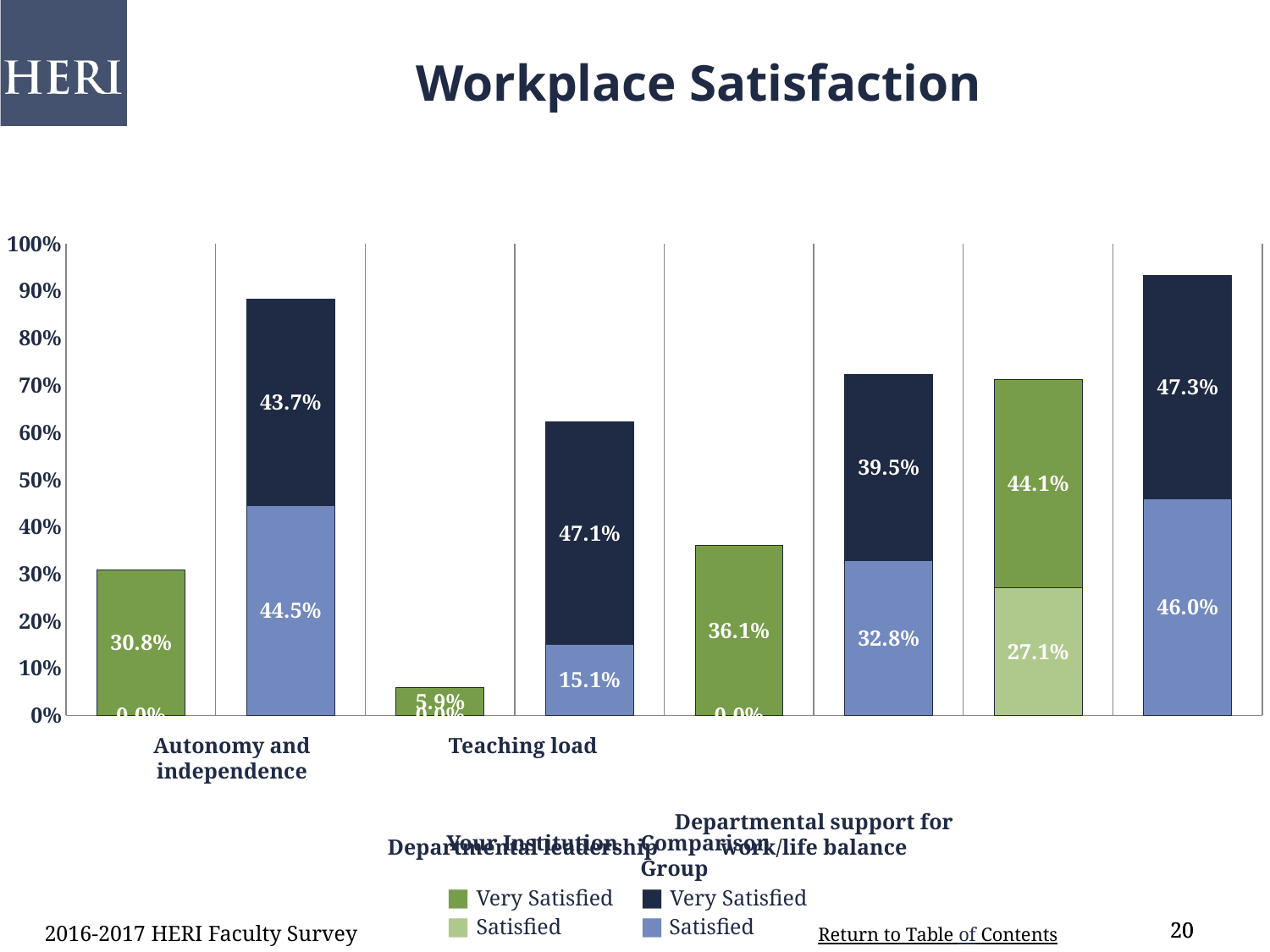
What kind of chart is shown on the slide? Stacked bar chart What percentage of Your Institution is Very Satisfied with Teaching load? 5.9% For Teaching load, how much larger is the Comparison Group's Very Satisfied value than its Satisfied value? 32.0 percentage points What is the total height of the Comparison Group stacked bar for Autonomy and independence? 88.2% Which category has the highest Your Institution Very Satisfied value? Departmental support for work/life balance Which category has the lowest Your Institution Very Satisfied value? Teaching load Is the total of the Comparison Group stacked bar for Departmental support for work/life balance greater or less than 90%? greater What percentage of the Comparison Group is Satisfied with Departmental support for work/life balance? 46.0% How many series does the legend list? 4 What percentage of the Comparison Group is Very Satisfied with Autonomy and independence? 43.7% What is the total height of the Your Institution stacked bar for Departmental support for work/life balance? 71.2% Which has a higher Your Institution Very Satisfied value: Autonomy and independence or Departmental leadership? Departmental leadership